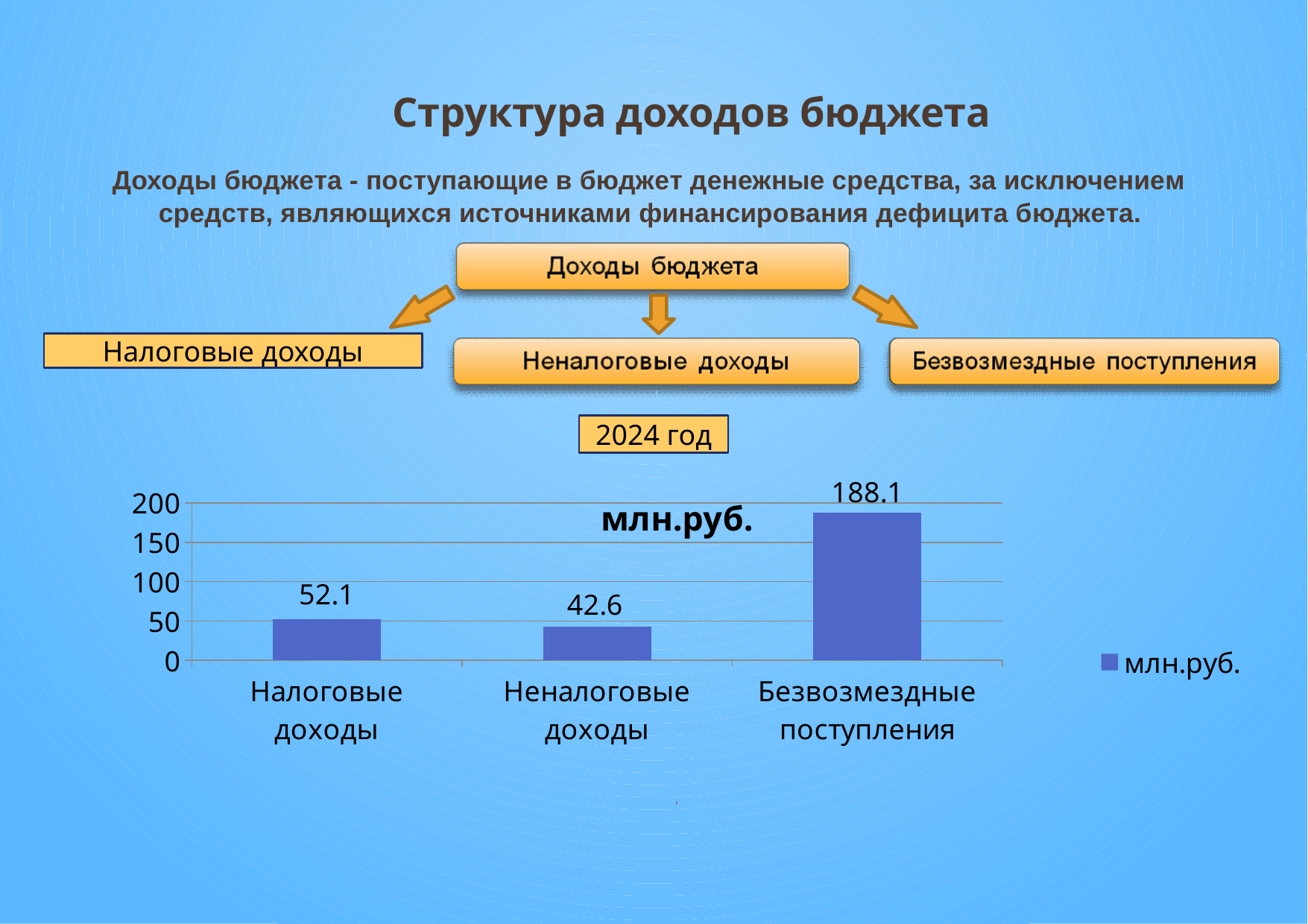
What series name does the legend show? млн.руб. What is the value for Налоговые доходы? 52.1 Which category has the lowest value? Неналоговые доходы Which is larger, Налоговые доходы or Неналоговые доходы? Налоговые доходы How many categories are shown in the chart? 3 What kind of chart is shown on the slide? bar chart What is the value for Неналоговые доходы? 42.6 What is the value for Безвозмездные поступления? 188.1 What is the difference between Налоговые доходы and Неналоговые доходы? 9.5 What is the difference between Безвозмездные поступления and Налоговые доходы? 136 Is the value for Безвозмездные поступления greater or less than 150? greater Which category has the highest value? Безвозмездные поступления